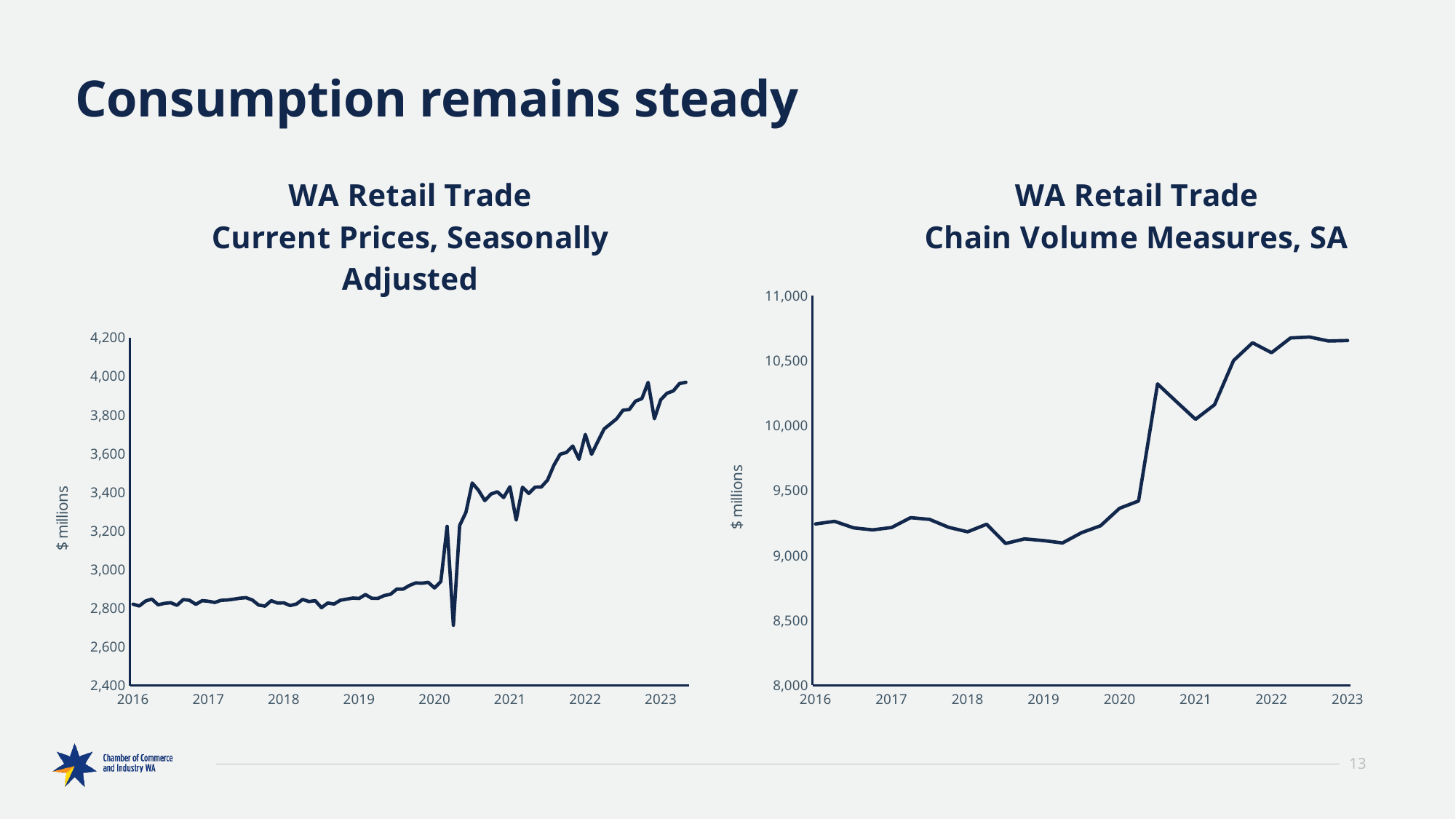
What is the y-axis label of the left chart, 'WA Retail Trade Current Prices, Seasonally Adjusted'? $ millions How many year labels are shown on the x axis of the right chart, 'WA Retail Trade Chain Volume Measures, SA'? 8 In the left chart, 'WA Retail Trade Current Prices, Seasonally Adjusted', is the value at the start of 2016 greater or less than 3,000? less In the left chart, 'WA Retail Trade Current Prices, Seasonally Adjusted', do the values overall rise or fall from 2016 to 2023? Rise In the left chart, 'WA Retail Trade Current Prices, Seasonally Adjusted', is the value at 2023 larger or smaller than the value at 2016? Larger In the left chart, 'WA Retail Trade Current Prices, Seasonally Adjusted', is the value at 2023 greater or less than 3,800? greater What kind of chart is the left chart, 'WA Retail Trade Current Prices, Seasonally Adjusted'? Line chart In the right chart, 'WA Retail Trade Chain Volume Measures, SA', is the value at the start of 2016 greater or less than 9,500? less What kind of chart is the right chart, 'WA Retail Trade Chain Volume Measures, SA'? Line chart In the right chart, 'WA Retail Trade Chain Volume Measures, SA', do the values overall rise or fall from 2016 to 2023? Rise